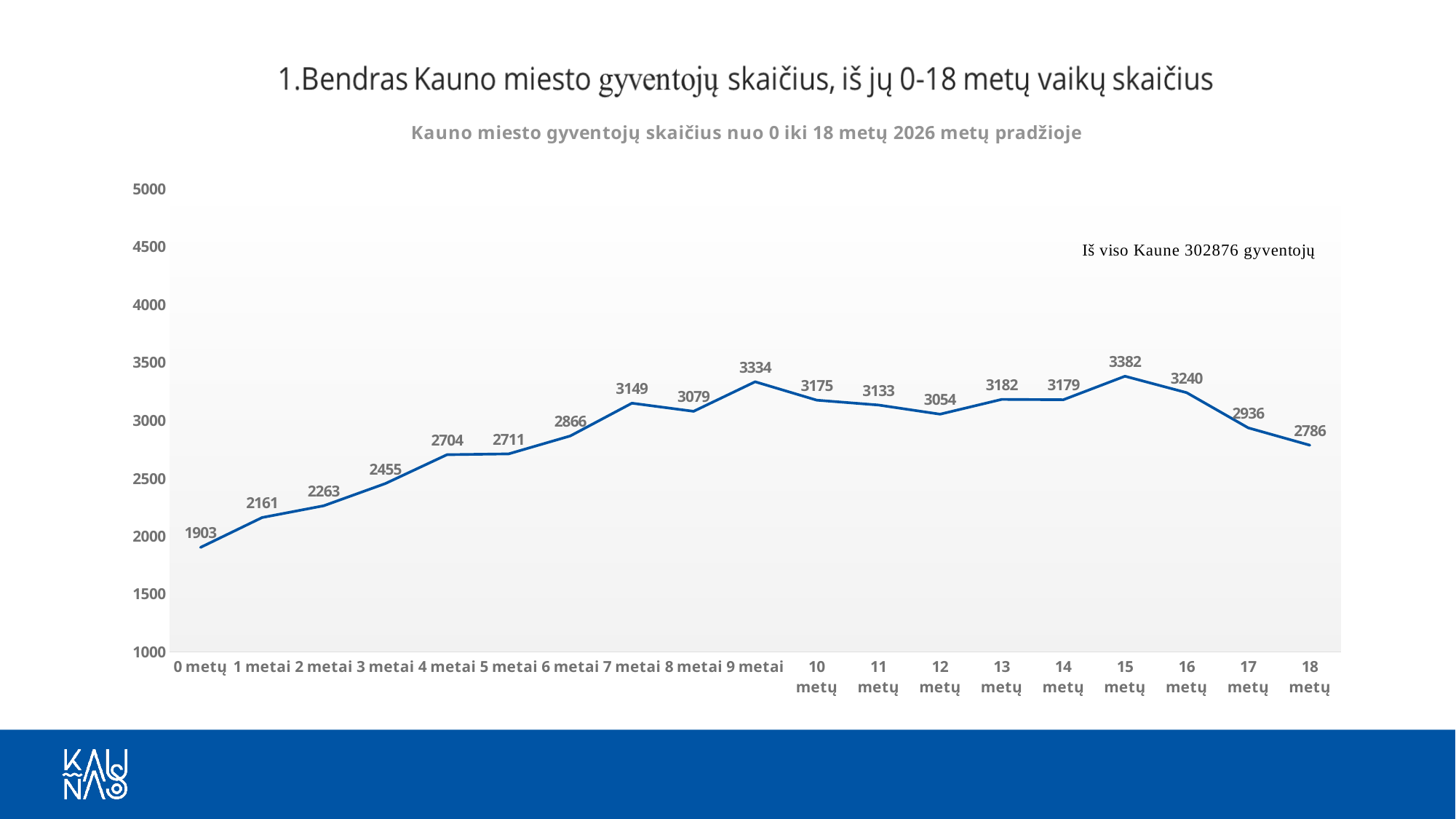
Do the values rise or fall from 0 metų to 4 metai? rise What is the value for 18 metų? 2786 How many age categories are plotted on the x axis? 19 What is the value for 9 metai? 3334 What total number of Kaunas residents is stated in the text on the chart? 302876 Which is larger, the value for 7 metai or the value for 8 metai? 7 metai What is the difference between the values for 15 metų and 0 metų? 1479 What kind of chart is shown on the slide? line chart Is the value for 3 metai greater or less than 2500? less What is the value for 0 metų? 1903 Which age category has the highest value? 15 metų Which age category has the lowest value? 0 metų